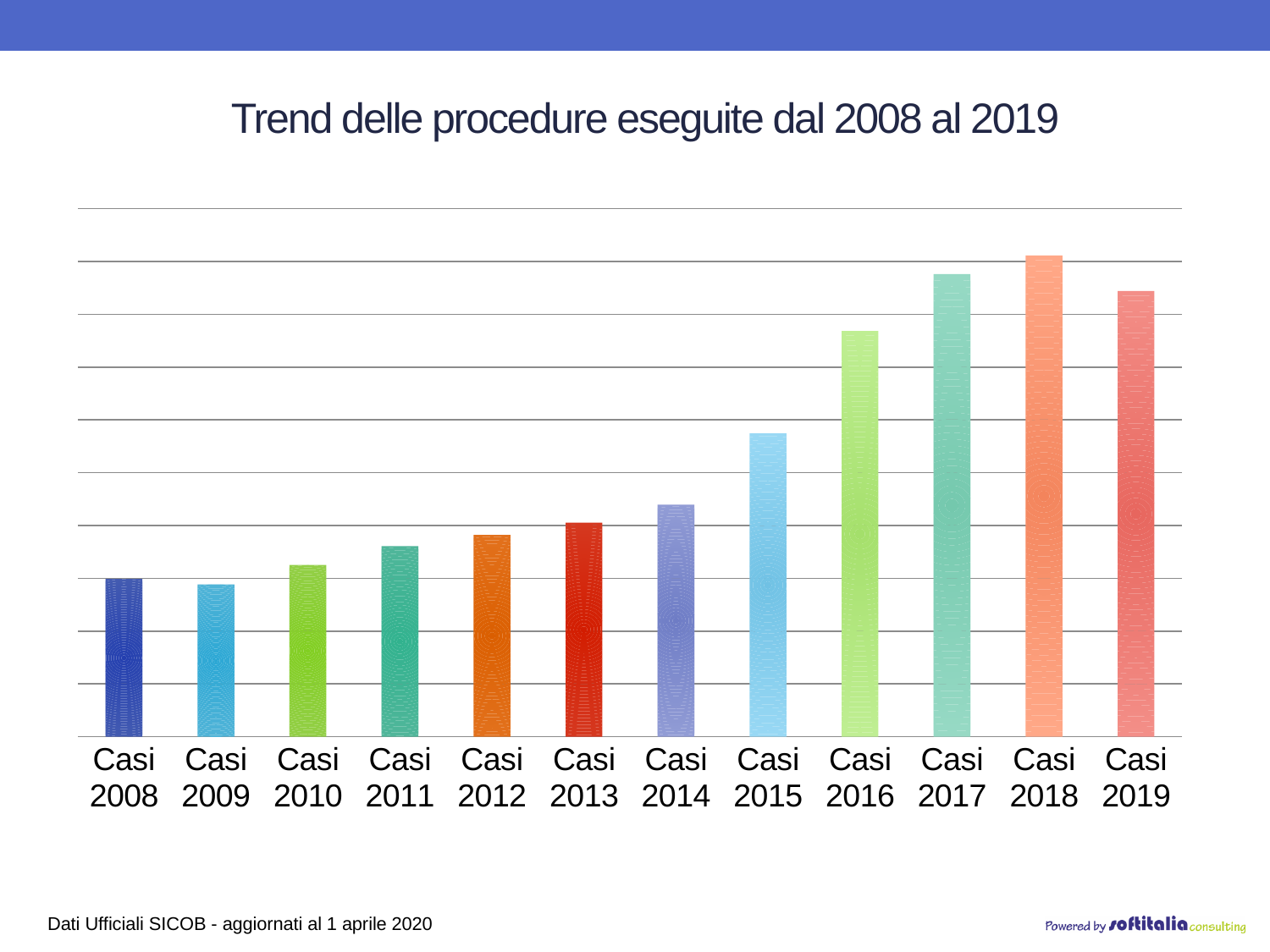
Do the values generally rise or fall from Casi 2009 to Casi 2018? Rise Does the value rise or fall from Casi 2018 to Casi 2019? Fall Which is larger, the value for Casi 2013 or Casi 2014? Casi 2014 Which is larger, the value for Casi 2015 or Casi 2016? Casi 2016 What type of chart is shown on the slide? Bar chart Which category has the highest bar? Casi 2018 Which is larger, the value for Casi 2010 or Casi 2012? Casi 2012 How many categories (years) are plotted on the x axis? 12 What data source is cited at the bottom of the slide? Dati Ufficiali SICOB - aggiornati al 1 aprile 2020 What is the title of the chart? Trend delle procedure eseguite dal 2008 al 2019